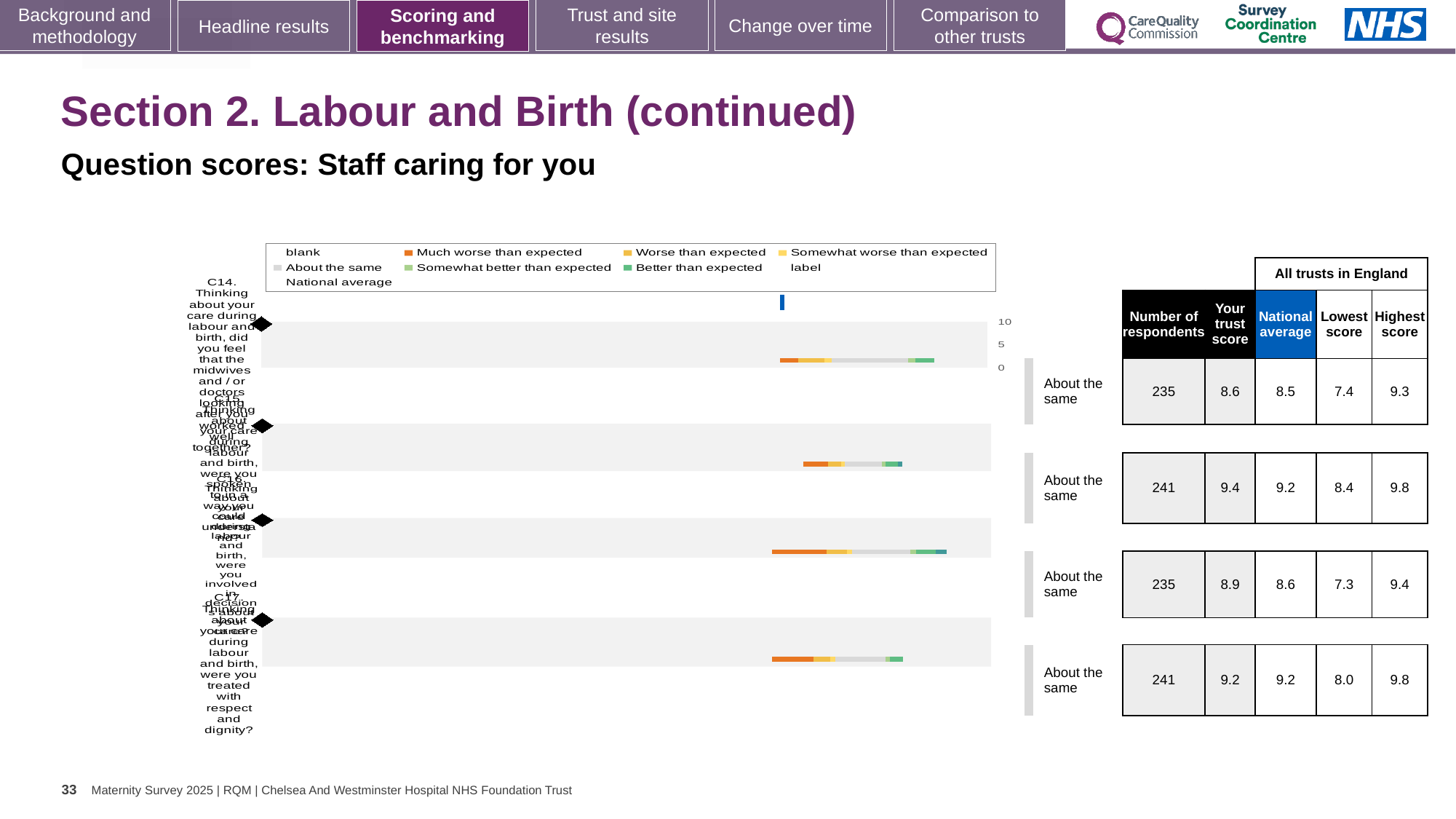
How many question rows (categories) does the chart show? 4 What is the difference between the trust score and the national average for the third row (C16)? 0.3 What is the national average for the second row (C15) of the chart? 9.2 Which row of the chart has the highest trust score? the second row (C15), 9.4 Which row of the chart has the lowest trust score? the top row (C14), 8.6 What kind of chart is shown on the slide? bar chart In the chart legend, what colour represents 'Better than expected'? green How many respondents are shown for the bottom row (C17) of the chart? 241 For the second row (C15), which is larger: the trust score or the national average? the trust score (9.4) Is the trust score for the top row (C14) greater or less than 5? greater What is the trust score for the top row (C14) of the chart? 8.6 In the chart legend, what colour represents 'Much worse than expected'? orange